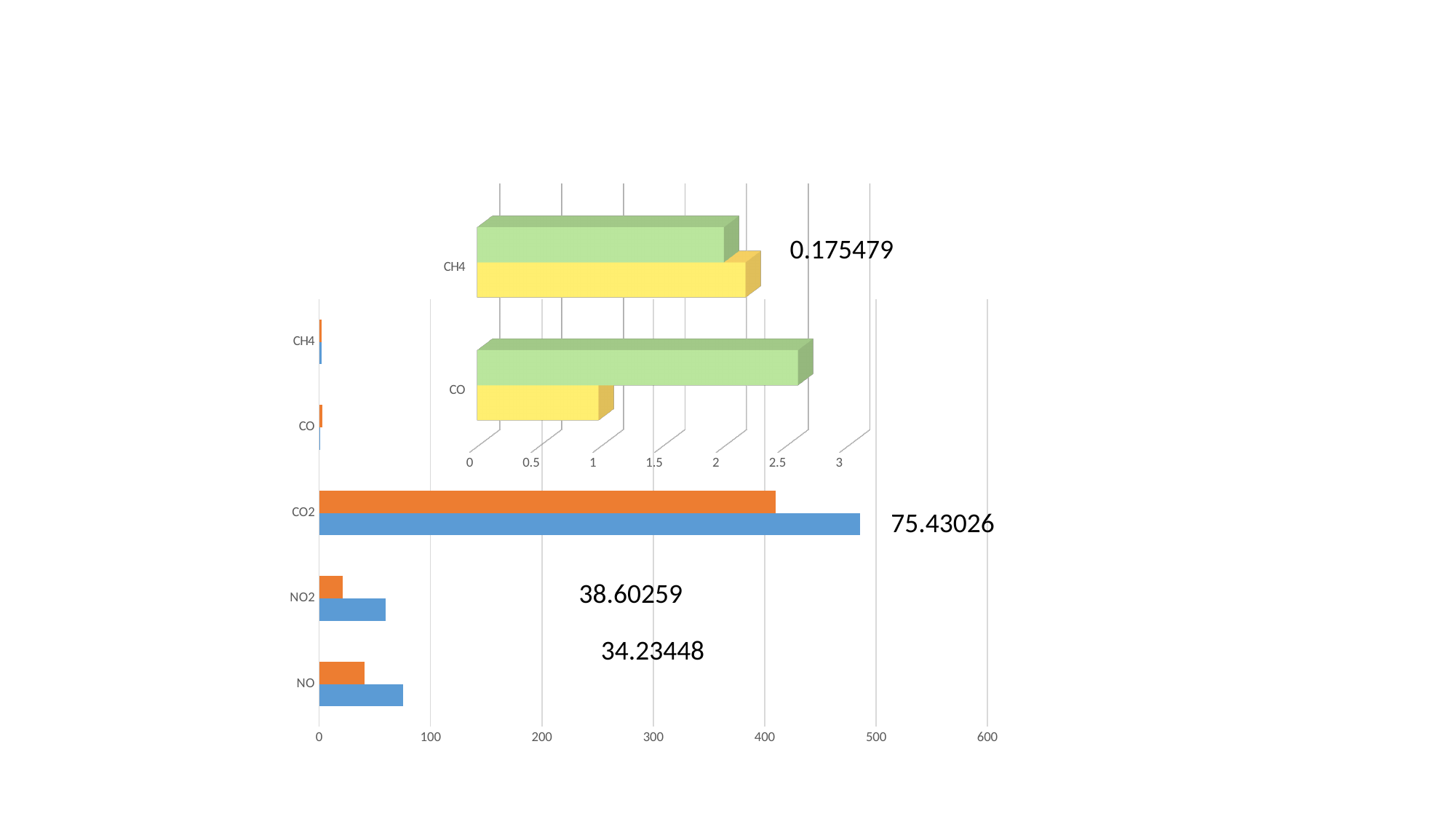
On the large chart with the 0–600 axis, which category has the longest blue bar? CO2 On the large chart with the 0–600 axis, which has the longer blue bar: NO or NO2? NO On the smaller inset chart with the 0–3 axis, which is larger for CO: the green bar or the yellow bar? the green bar On the large chart with the 0–600 axis, is the blue bar for CO2 greater or less than 400? greater On the large chart with the 0–600 axis, which is larger for CO2: the blue bar or the orange bar? the blue bar On the large chart with the 0–600 axis, is the blue bar for NO greater or less than 100? less What kind of chart is the smaller inset chart with the 0–3 axis? bar chart On the smaller inset chart with the 0–3 axis, is the yellow bar for CO greater or less than 1.5? less What kind of chart is the large chart with the 0–600 axis? bar chart How many categories are shown on the large chart with the 0–600 axis? 5 How many categories are shown on the smaller inset chart with the 0–3 axis? 2